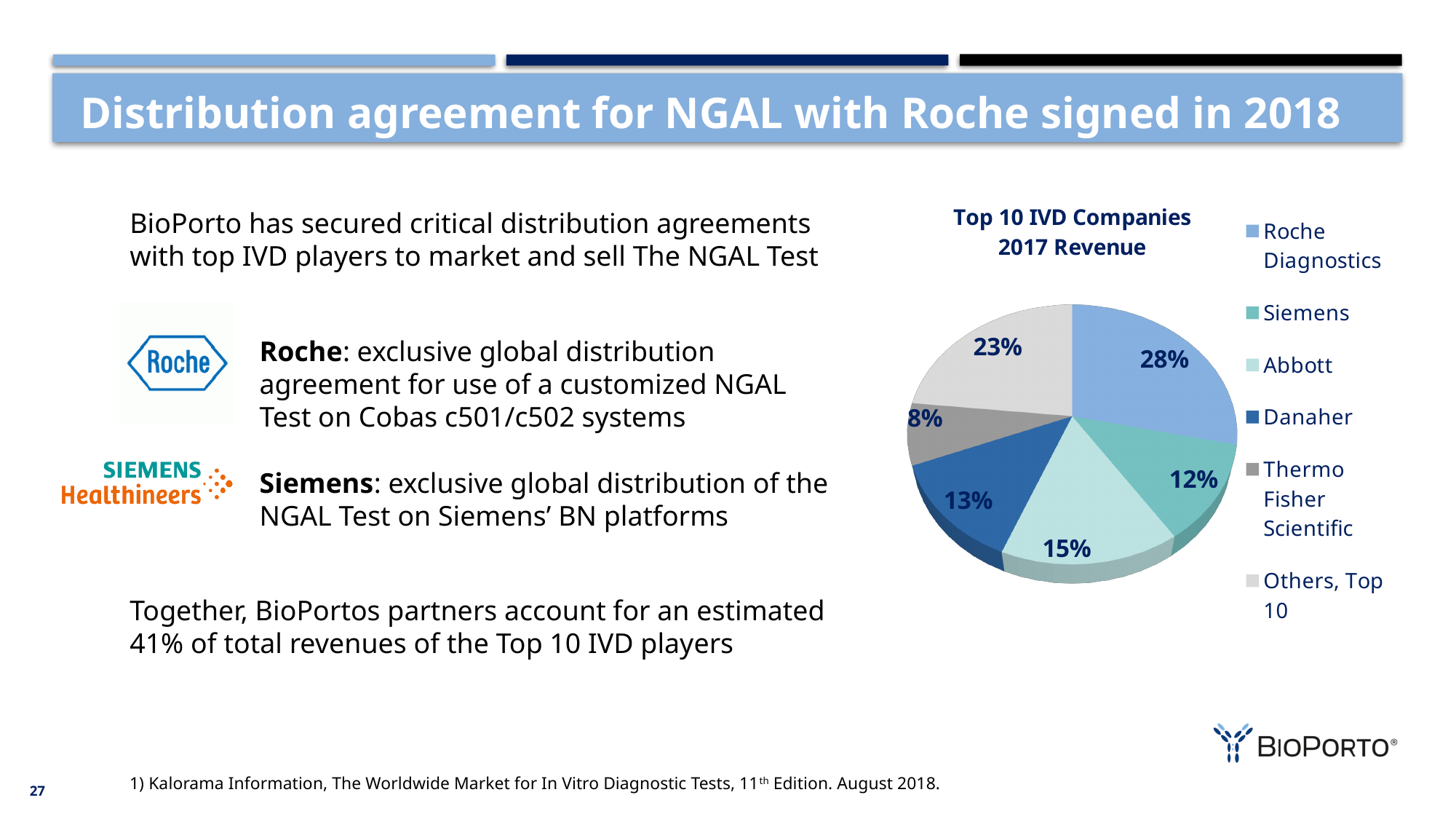
What kind of chart is shown on the slide? Pie chart Which company has the smallest slice of the pie? Thermo Fisher Scientific What is the difference in percentage points between the Roche Diagnostics slice and the Siemens slice? 16 percentage points What share of the pie is labelled Others, Top 10? 23% What share of the pie does Siemens hold? 12% What share of the pie does Roche Diagnostics hold? 28% Which named company has the largest slice of the pie? Roche Diagnostics What share of the pie does Abbott hold? 15% How many entries does the chart legend list? 6 What share of the pie does Danaher hold? 13% What is the title of the chart? Top 10 IVD Companies 2017 Revenue What share of the pie does Thermo Fisher Scientific hold? 8%